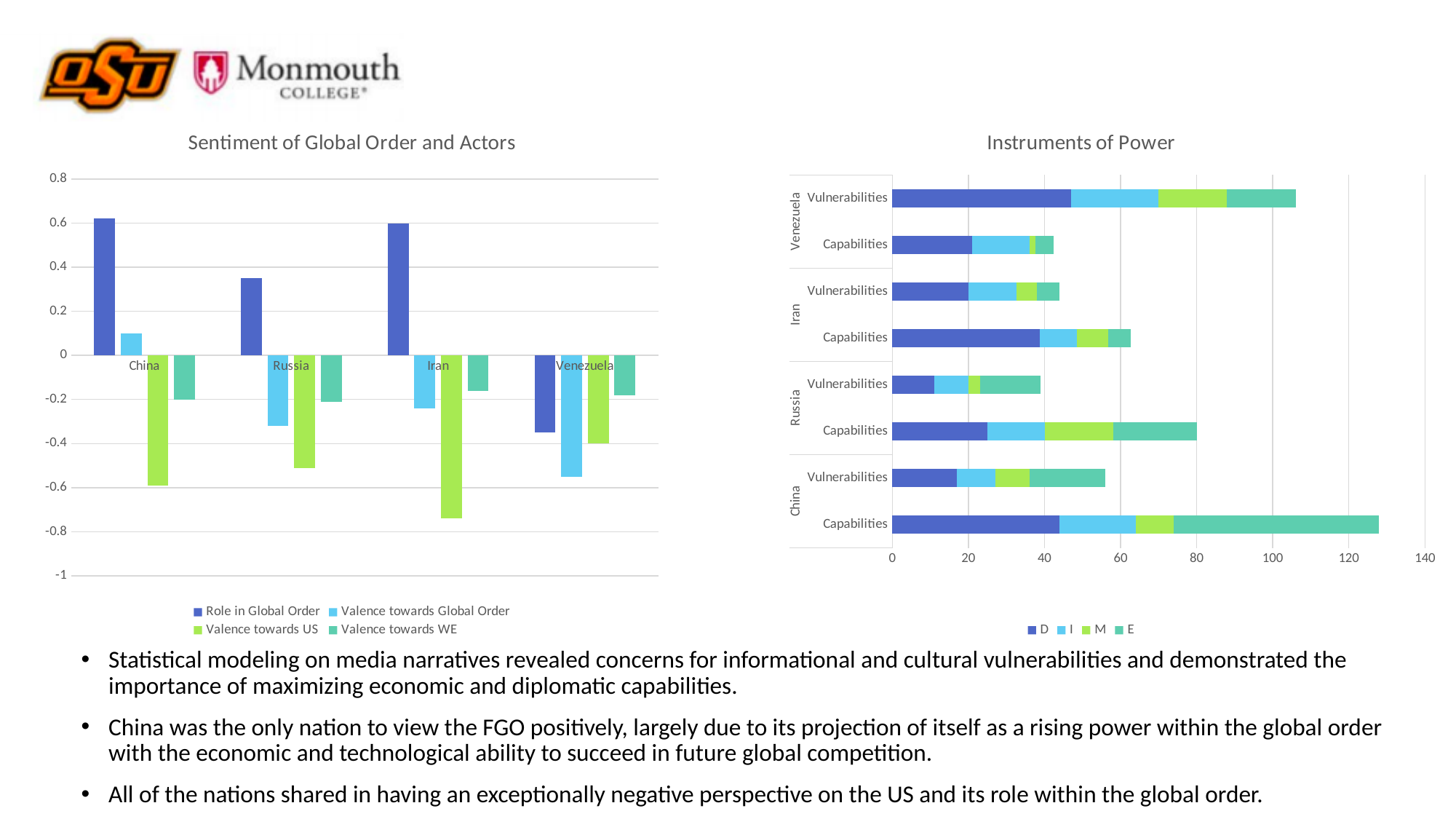
In the "Instruments of Power" chart, which bar has the largest total? China Capabilities In the "Sentiment of Global Order and Actors" chart, is the Role in Global Order value for China greater or less than 0.4? greater In the "Instruments of Power" chart, which is larger for Iran: Capabilities or Vulnerabilities? Capabilities In the "Sentiment of Global Order and Actors" chart, is the Valence towards US value for Iran greater or less than -0.6? less In the "Instruments of Power" chart, is the total for Venezuela Vulnerabilities greater or less than 100? greater In the "Sentiment of Global Order and Actors" chart, which country has the lowest value for Valence towards US? Iran In the "Sentiment of Global Order and Actors" chart, which country has the highest value for Valence towards Global Order? China How many countries are shown on the x axis of the "Sentiment of Global Order and Actors" chart? 4 What type of chart is the "Sentiment of Global Order and Actors" chart? Bar chart In the "Sentiment of Global Order and Actors" chart, which country has the lowest value for Role in Global Order? Venezuela In the "Instruments of Power" chart, which series is shown in dark blue? D How many series does the legend of the "Instruments of Power" chart list? 4